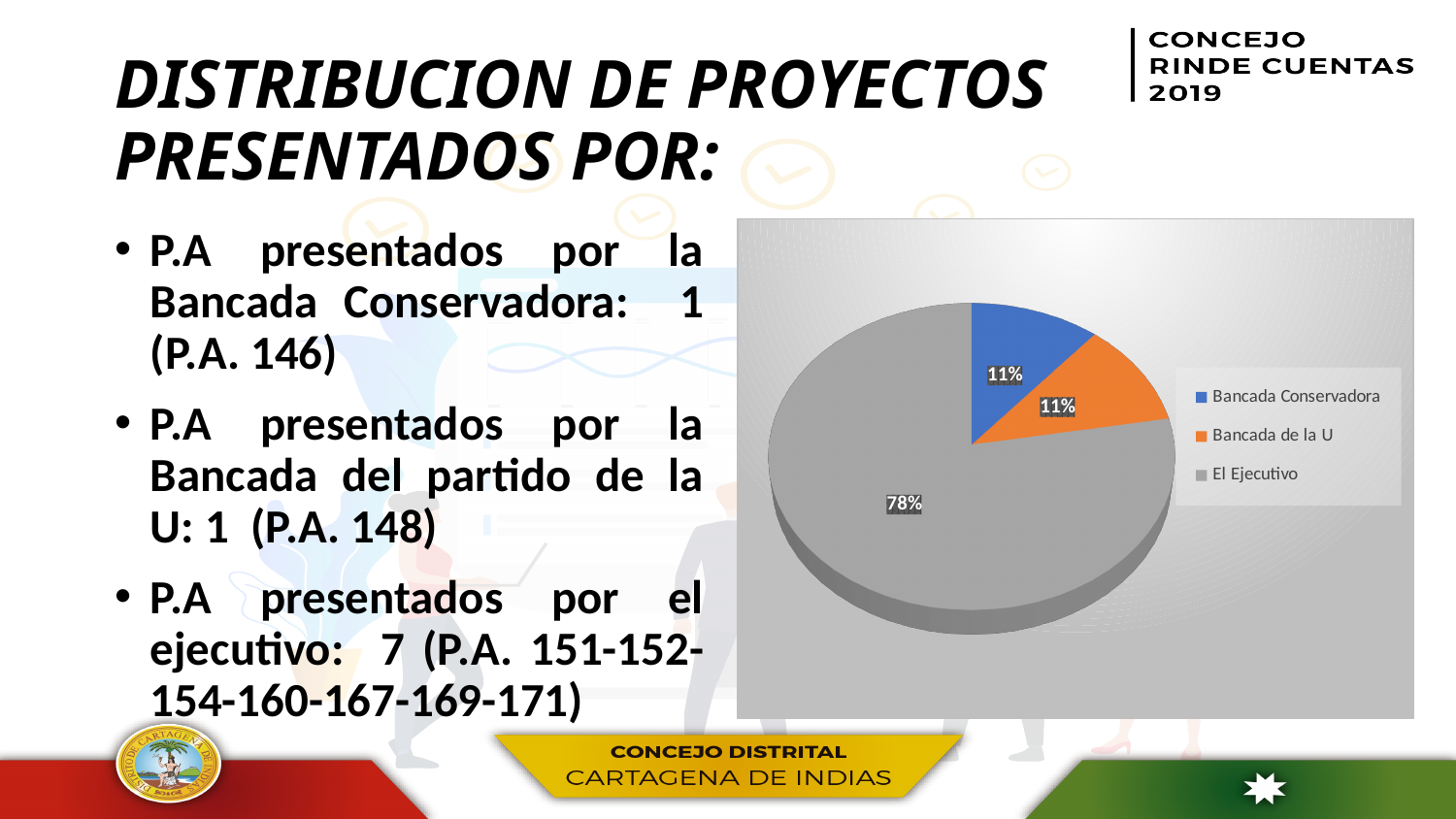
What share of the pie does El Ejecutivo represent? 78% Which colour represents El Ejecutivo in the pie chart? gray How many entries does the legend of the pie chart list? 3 What is the difference in percentage points between El Ejecutivo and Bancada Conservadora? 67 Which legend entry is shown in orange? Bancada de la U Is the share for El Ejecutivo greater or less than 50%? greater What kind of chart is shown on the slide? pie chart What share of the pie does Bancada de la U represent? 11% How many slices does the pie chart have? 3 Which is larger in the pie chart, El Ejecutivo or Bancada de la U? El Ejecutivo What share of the pie does Bancada Conservadora represent? 11% Which category has the largest slice of the pie chart? El Ejecutivo